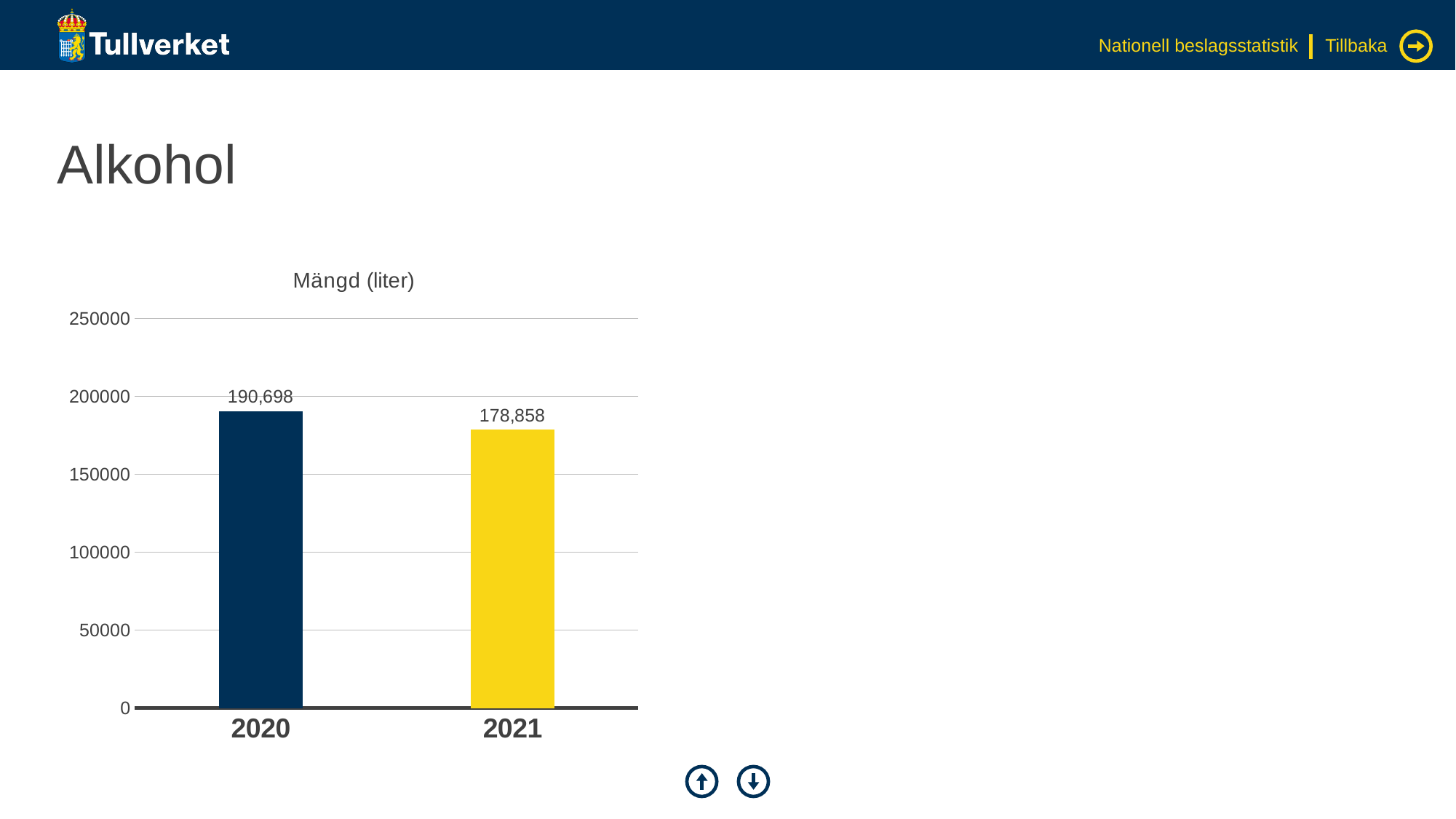
Do the values rise or fall from 2020 to 2021 in the Mängd (liter) chart? fall Is the value for 2021 in the Mängd (liter) chart greater or less than 200000? less Which year has the lowest value in the Mängd (liter) chart? 2021 What is the difference between the 2020 and 2021 values in the Mängd (liter) chart? 11,840 Is the value for 2020 in the Mängd (liter) chart greater or less than 150000? greater What kind of chart is shown on the slide? bar chart What is the value for 2020 in the Mängd (liter) chart? 190,698 How many bars are shown in the Mängd (liter) chart? 2 What is the value for 2021 in the Mängd (liter) chart? 178,858 Which is larger in the Mängd (liter) chart, the value for 2020 or for 2021? 2020 Which year has the highest value in the Mängd (liter) chart? 2020 What is the title of the chart on the slide? Mängd (liter)